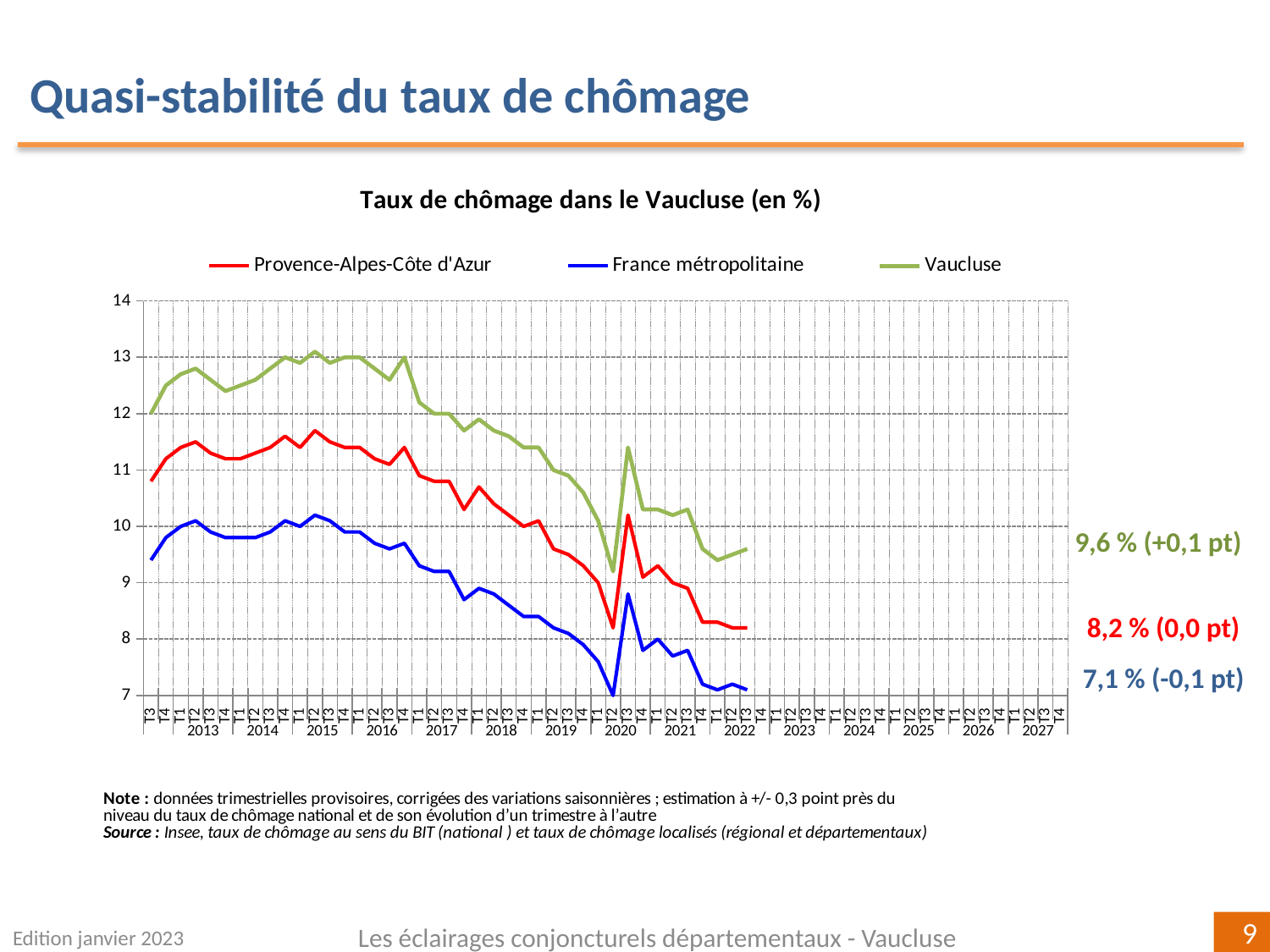
What is the latest unemployment rate shown for Vaucluse? 9,6 % What change is indicated next to the latest Vaucluse value? +0,1 pt Is the value for France métropolitaine in T2 2020 greater or less than 8? less What is the difference between the latest Vaucluse value and the latest Provence-Alpes-Côte d'Azur value? 1,4 pt How many series does the legend list? 3 What is the latest unemployment rate shown for Provence-Alpes-Côte d'Azur? 8,2 % Which series has the lowest latest value? France métropolitaine Which series has the highest latest value: Vaucluse, Provence-Alpes-Côte d'Azur or France métropolitaine? Vaucluse Overall, do the unemployment rates rise or fall from 2013 to 2022? fall What is the title of the chart? Taux de chômage dans le Vaucluse (en %) What is the latest unemployment rate shown for France métropolitaine? 7,1 % What kind of chart is shown on the slide? line chart